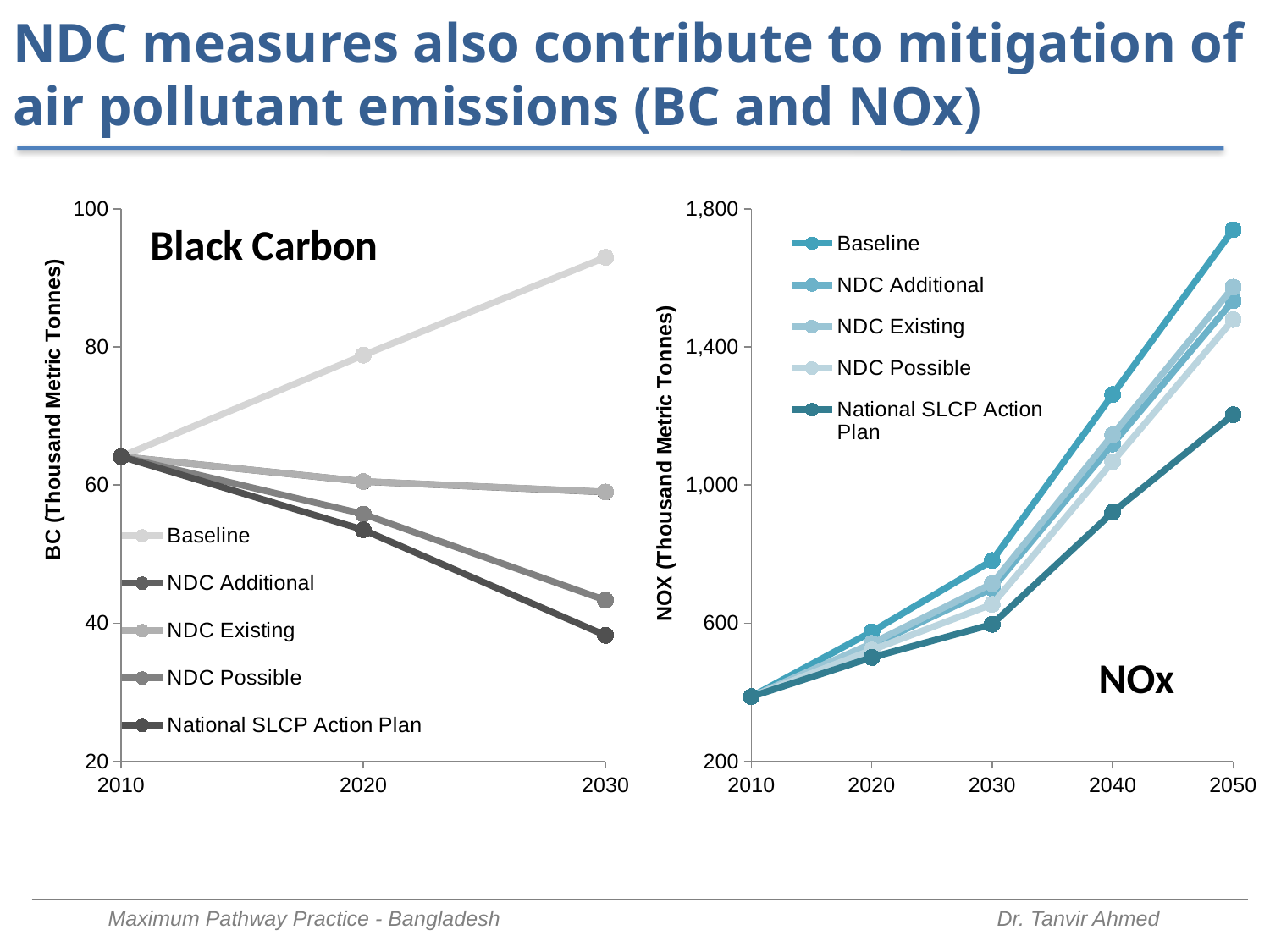
In the Black Carbon chart, which series has the lowest value in 2030? National SLCP Action Plan How many years are shown on the x axis of the NOx chart? 5 In the Black Carbon chart, which series has the highest value in 2030? Baseline In the NOx chart, is the Baseline value in 2050 larger or smaller than the National SLCP Action Plan value in 2050? larger In the NOx chart, is the National SLCP Action Plan value in 2050 greater or less than 1,400? less In the Black Carbon chart, does the National SLCP Action Plan series rise or fall from 2010 to 2030? fall How many series does the legend of the NOx chart list? 5 In the Black Carbon chart, is the Baseline value in 2030 greater or less than 80? greater In the NOx chart, which series has the highest value in 2050? Baseline In the Black Carbon chart, does the Baseline series rise or fall from 2010 to 2030? rise What kind of chart is the Black Carbon chart on the left? line chart How many years are shown on the x axis of the Black Carbon chart? 3